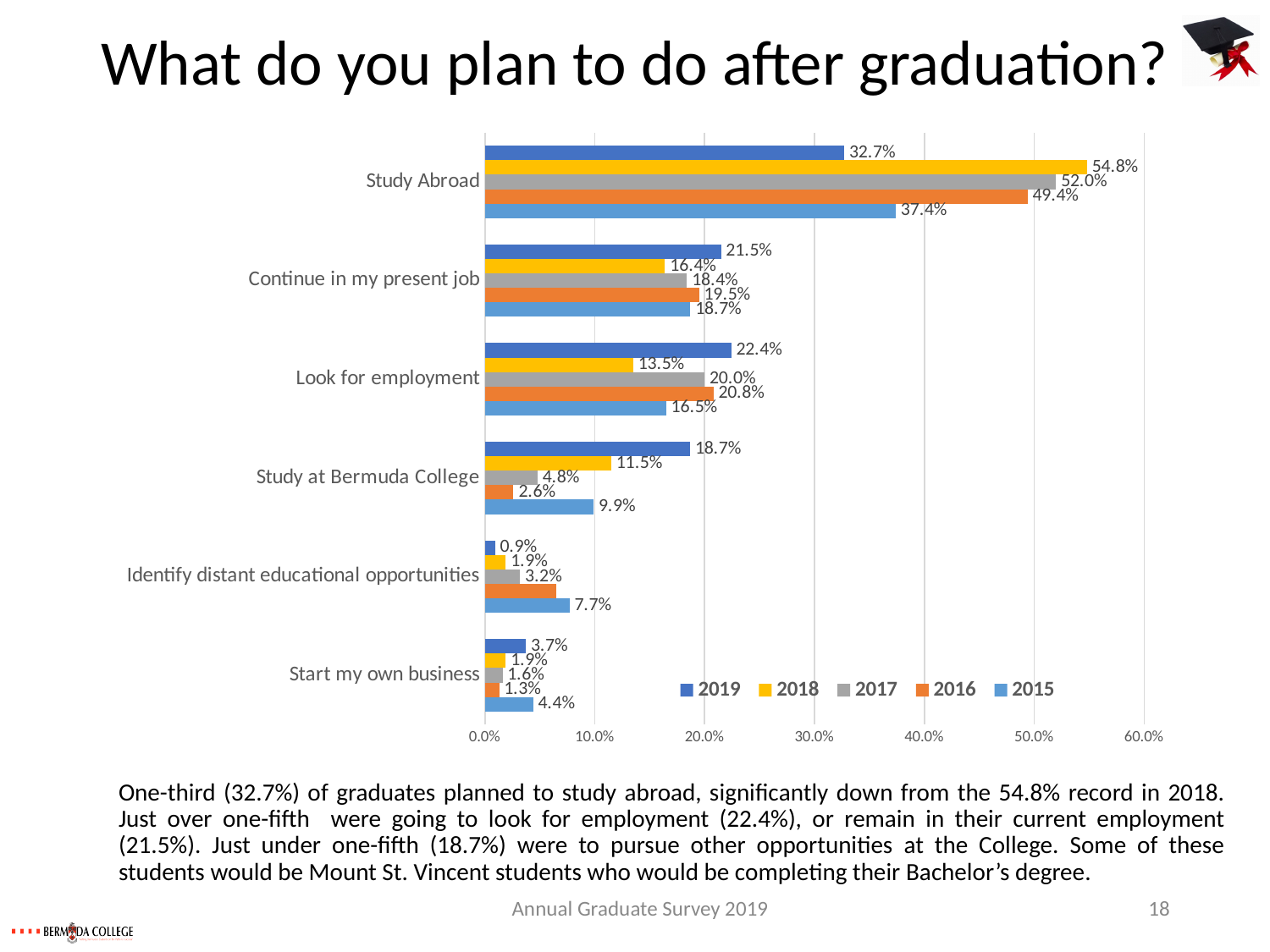
Which year has the highest value for Study Abroad? 2018 What is the 2018 value for Look for employment? 13.5% Which is larger for Continue in my present job: the 2019 value or the 2018 value? 2019 How many series does the legend list? 5 What is the 2019 value for Study Abroad? 32.7% What is the 2015 value for Study at Bermuda College? 9.9% How many categories are plotted on the chart? 6 What kind of chart is shown on the slide? bar chart Is the 2016 value for Identify distant educational opportunities greater or less than 10.0%? less Which year has the lowest value for Start my own business? 2016 What is the difference between the 2018 and 2019 values for Study Abroad? 22.1% Which colour represents the 2017 series in the legend? grey